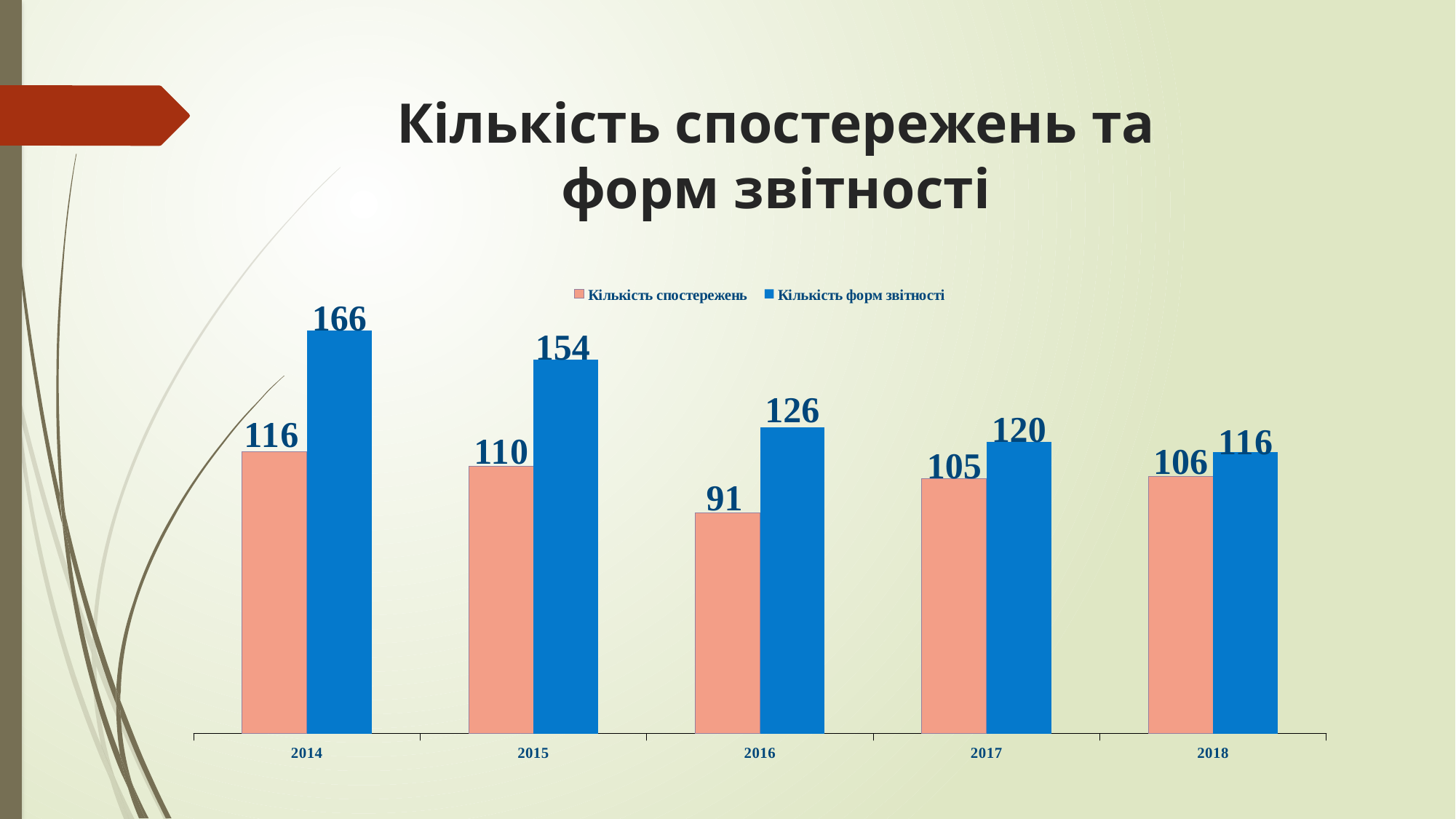
What is the value of Кількість форм звітності for 2018? 116 Which is larger in 2017: Кількість спостережень or Кількість форм звітності? Кількість форм звітності In which year is Кількість форм звітності highest? 2014 In which year is Кількість спостережень lowest? 2016 How many years are shown on the x axis? 5 What is the value of Кількість спостережень for 2014? 116 What is the difference between Кількість форм звітності and Кількість спостережень in 2015? 44 What is the title of the slide? Кількість спостережень та форм звітності What kind of chart is shown on the slide? bar chart How many series does the legend list? 2 What is the value of Кількість форм звітності for 2016? 126 Does Кількість форм звітності rise or fall from 2014 to 2018? fall